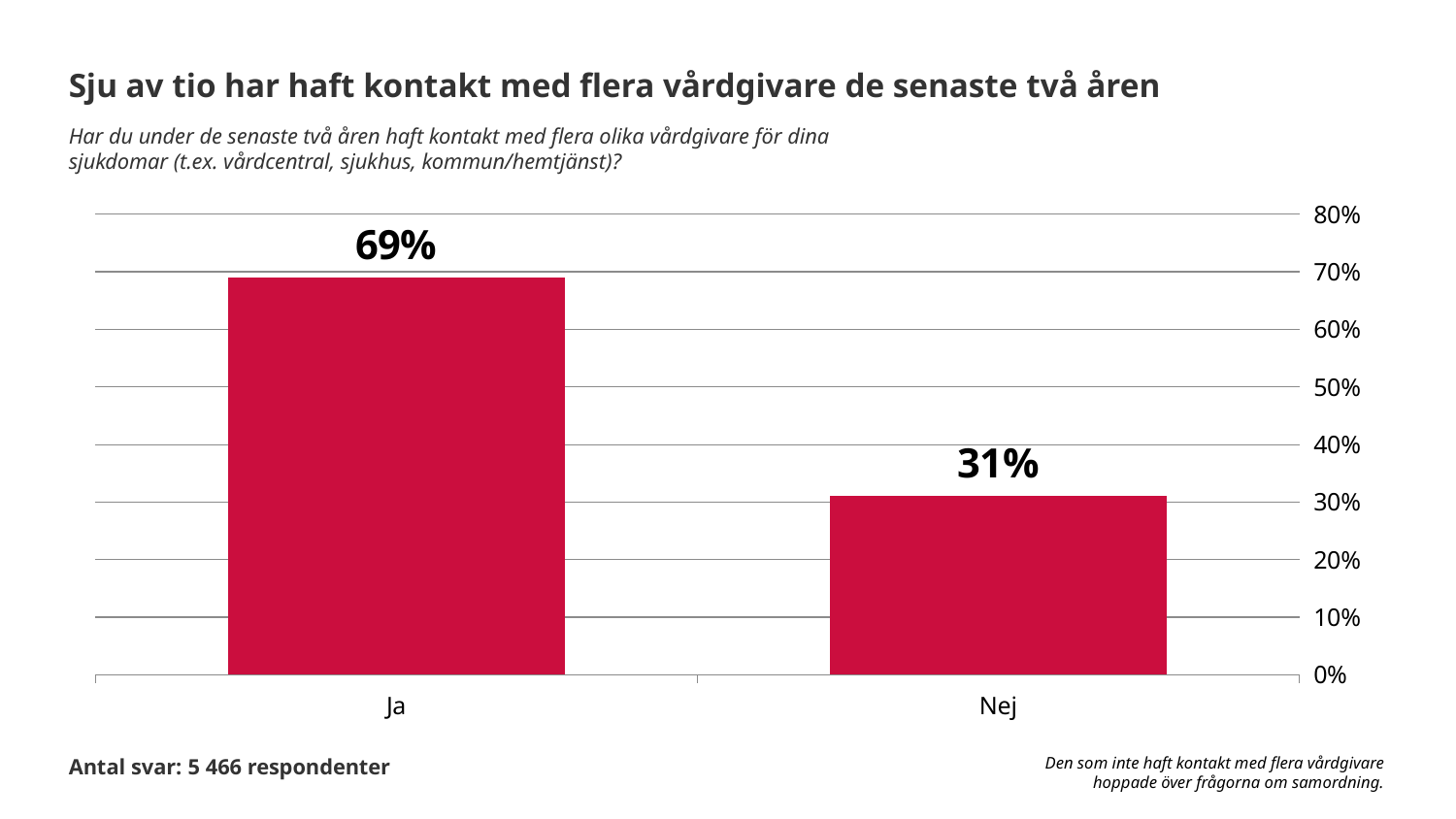
Is the value for "Nej" greater or less than 40%? less What is the difference between the values for "Ja" and "Nej"? 38% Which is larger, the value for "Ja" or the value for "Nej"? Ja Is the value for "Ja" greater or less than 60%? greater How many categories are shown on the x axis? 2 What is the value for "Nej"? 31% What kind of chart is shown on the slide? bar chart What is the value for "Ja"? 69% Which category has the lowest value? Nej Which category has the highest value? Ja What is the highest value shown on the y axis? 80% How many respondents answered the question, according to the slide? 5 466 respondenter